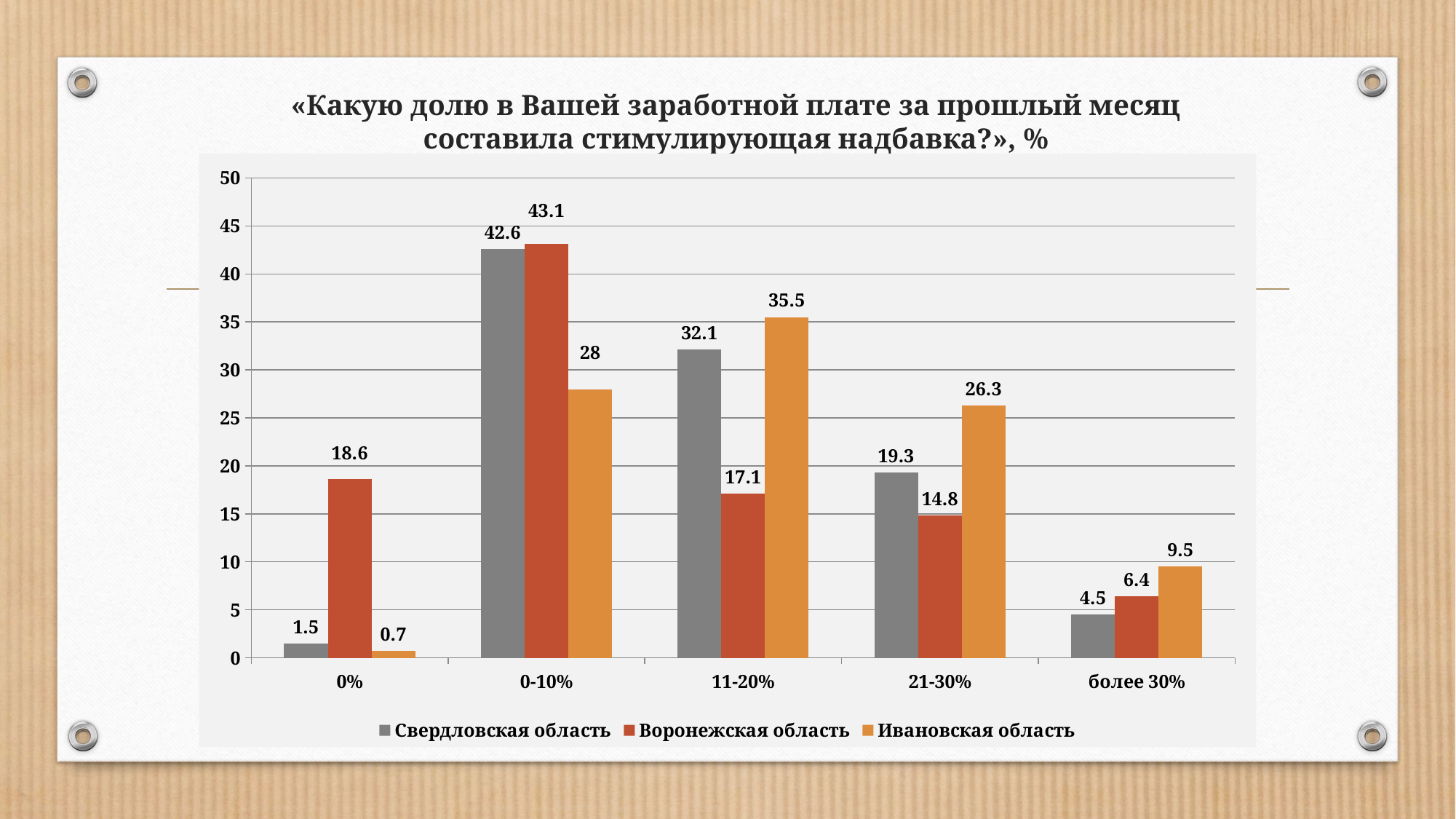
In the 11-20% category, which is larger: Свердловская область or Воронежская область? Свердловская область What kind of chart is shown on the slide? bar chart Which category has the lowest value for Свердловская область? 0% Which category has the highest value for Ивановская область? 11-20% Which series is shown in orange? Ивановская область How many categories are shown on the x axis? 5 How many series does the legend list? 3 What is the value for Воронежская область in the 0% category? 18.6 What is the value for Свердловская область in the 0-10% category? 42.6 What is the value for Ивановская область in the 11-20% category? 35.5 Is the value for Ивановская область in the 21-30% category greater or less than 25? greater What is the difference between Воронежская область and Свердловская область in the 21-30% category? 4.5